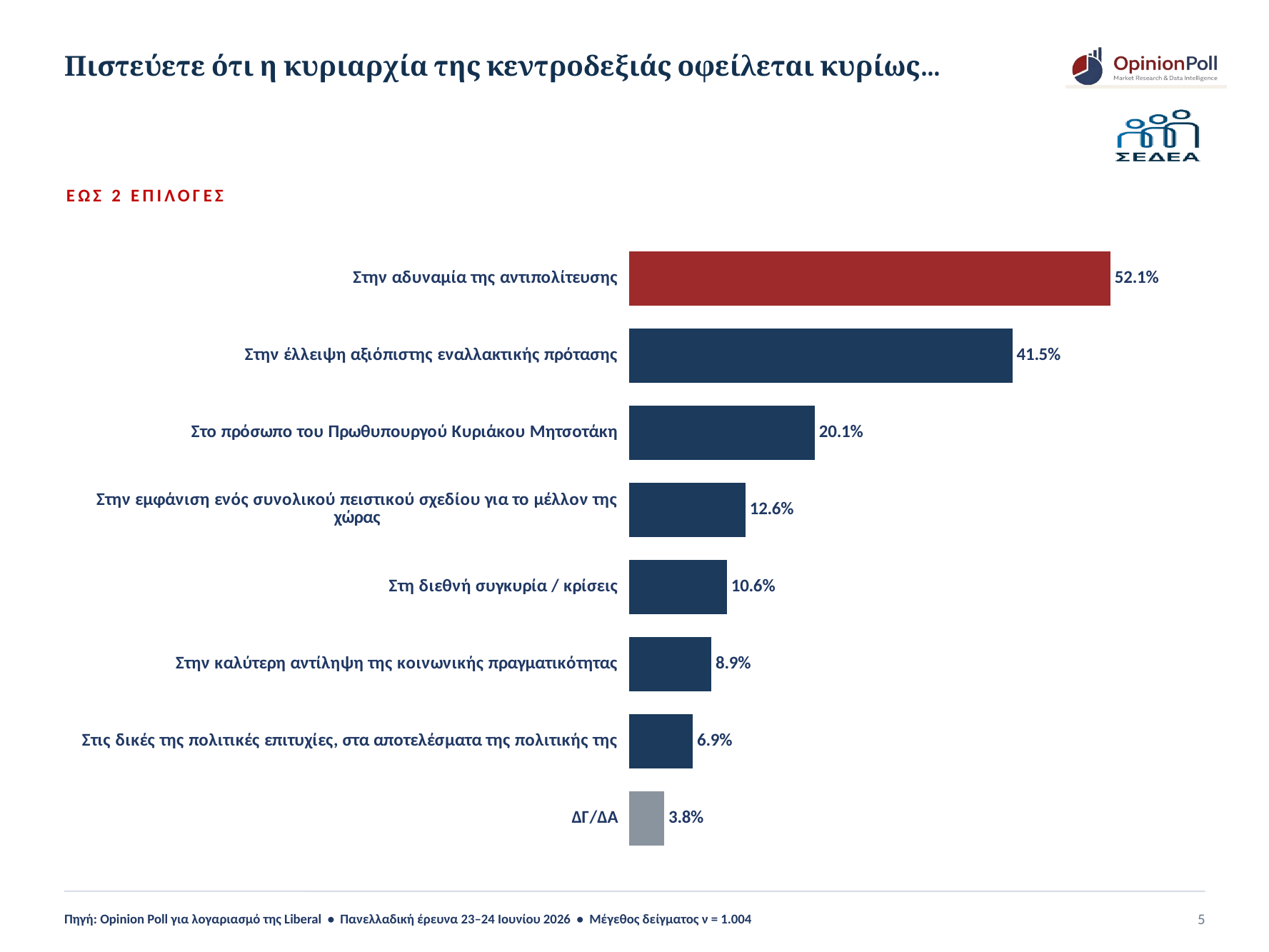
Which category has the lowest value? ΔΓ/ΔΑ Which bar is coloured red rather than dark blue? Στην αδυναμία της αντιπολίτευσης Which is larger: 'Στην καλύτερη αντίληψη της κοινωνικής πραγματικότητας' or 'Στη διεθνή συγκυρία / κρίσεις'? Στη διεθνή συγκυρία / κρίσεις What is the value for 'ΔΓ/ΔΑ'? 3.8% What is the value for 'Στη διεθνή συγκυρία / κρίσεις'? 10.6% How many categories are shown in the chart? 8 What is the value for 'Στο πρόσωπο του Πρωθυπουργού Κυριάκου Μητσοτάκη'? 20.1% What kind of chart is shown on the slide? Bar chart What is the value for 'Στην αδυναμία της αντιπολίτευσης'? 52.1% What is the difference between 'Στην αδυναμία της αντιπολίτευσης' and 'Στην έλλειψη αξιόπιστης εναλλακτικής πρότασης'? 10.6% What is the difference between 'Στην εμφάνιση ενός συνολικού πειστικού σχεδίου για το μέλλον της χώρας' and 'Στις δικές της πολιτικές επιτυχίες, στα αποτελέσματα της πολιτικής της'? 5.7% Which category has the highest value? Στην αδυναμία της αντιπολίτευσης